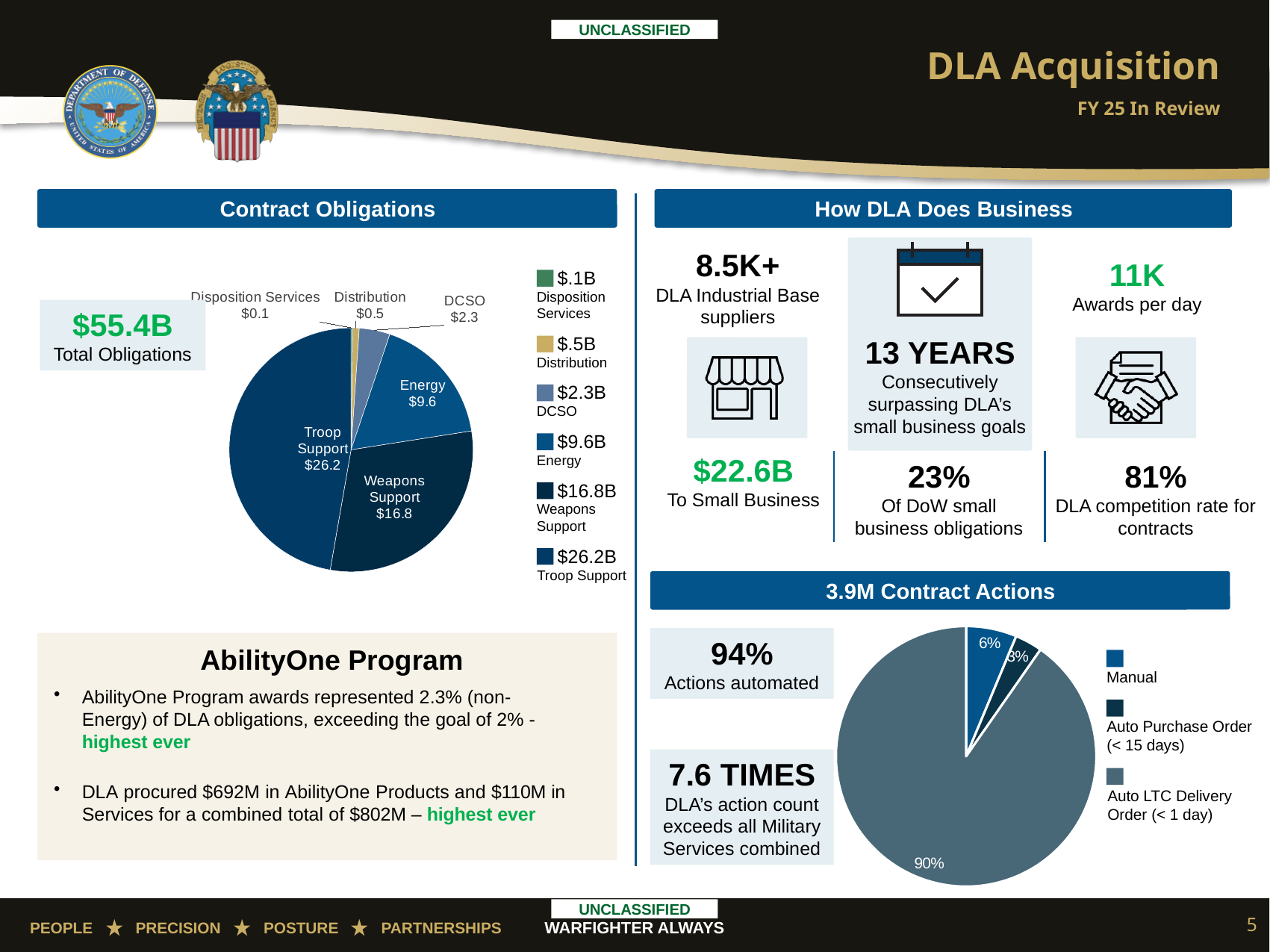
What type of chart is used under Contract Obligations? Pie chart How many categories are shown in the Contract Obligations pie chart? 6 In the Contract Obligations pie chart, which category has the smallest slice? Disposition Services In the 3.9M Contract Actions pie chart, what share is Auto LTC Delivery Order (< 1 day)? 90% In the Contract Obligations pie chart, which is larger, DCSO or Energy? Energy In the Contract Obligations pie chart, what is the difference between Troop Support and Weapons Support? $9.4 In the 3.9M Contract Actions pie chart, what share is Manual? 6% How many entries does the legend of the 3.9M Contract Actions pie chart list? 3 In the Contract Obligations pie chart, which category has the largest slice? Troop Support In the Contract Obligations pie chart, what is the value for Weapons Support? $16.8 In the Contract Obligations pie chart, what is the value for Energy? $9.6 In the 3.9M Contract Actions pie chart, which category has the smallest slice? Auto Purchase Order (< 15 days)